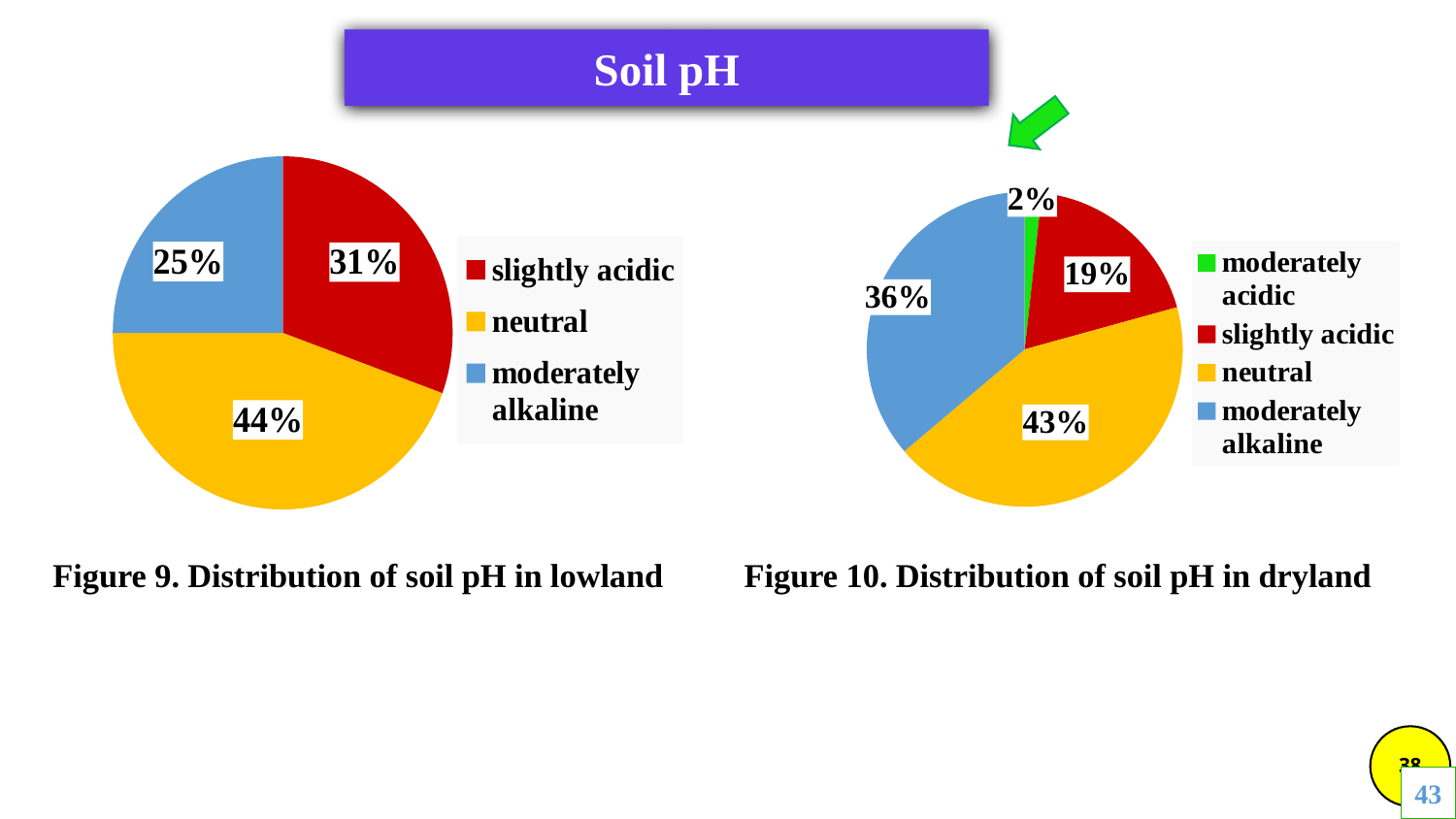
In the Figure 10 dryland pie chart, what share is moderately acidic? 2% In the Figure 9 lowland pie chart, how many categories does the legend list? 3 In the Figure 10 dryland pie chart, how many categories does the legend list? 4 In the Figure 9 lowland pie chart, what share is neutral? 44% In the Figure 10 dryland pie chart, what colour represents moderately acidic? green In the Figure 9 lowland pie chart, what share is slightly acidic? 31% In the Figure 10 dryland pie chart, which is larger, slightly acidic or moderately alkaline? moderately alkaline In the Figure 10 dryland pie chart, what share is moderately alkaline? 36% In the Figure 9 lowland pie chart, what is the difference between the neutral and slightly acidic shares? 13% What type of chart is used in Figure 9 and Figure 10? pie chart In the Figure 10 dryland pie chart, which category has the largest share? neutral In the Figure 9 lowland pie chart, which category has the smallest share? moderately alkaline